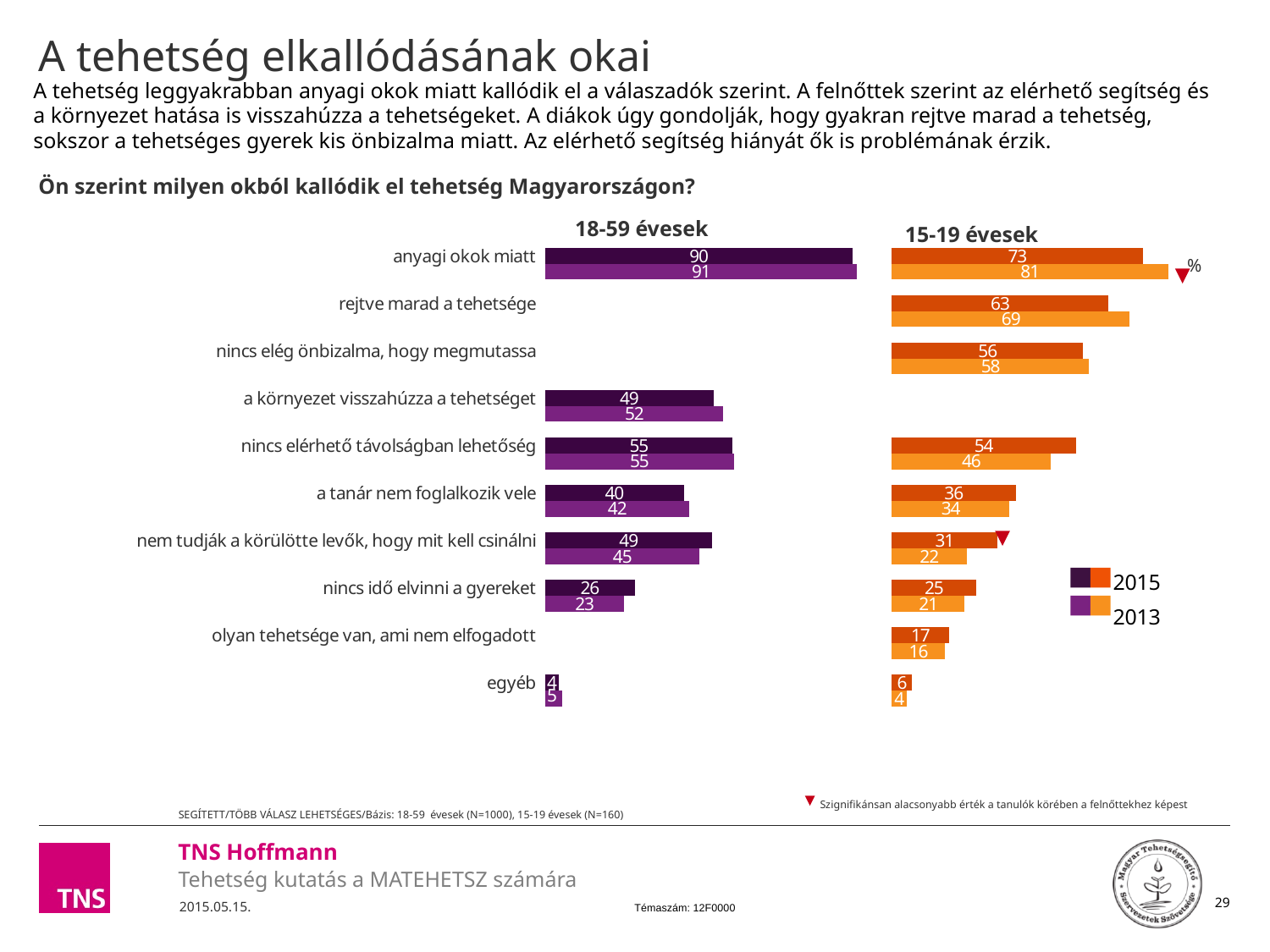
How many series does the legend list? 2 In the "15-19 évesek" chart, is the 2015 value for "nincs elérhető távolságban lehetőség" larger or smaller than the 2013 value? larger What kind of chart is used on this slide? bar chart In the "18-59 évesek" chart, which category has the highest 2015 value? anyagi okok miatt In the "18-59 évesek" chart, what is the difference between the 2015 and 2013 values for "nem tudják a körülötte levők, hogy mit kell csinálni"? 4 How many categories are shown in the "15-19 évesek" chart? 9 In the "15-19 évesek" chart, what is the 2013 value for "rejtve marad a tehetsége"? 69 In the "15-19 évesek" chart, which category has the lowest 2013 value? egyéb In the "15-19 évesek" chart, what is the 2015 value for "nem tudják a körülötte levők, hogy mit kell csinálni"? 31 In the "18-59 évesek" chart, is the 2015 value for "nincs idő elvinni a gyereket" larger or smaller than the 2013 value? larger In the "15-19 évesek" chart, what is the difference between the 2013 and 2015 values for "anyagi okok miatt"? 8 In the "18-59 évesek" chart, what is the 2015 value for "anyagi okok miatt"? 90